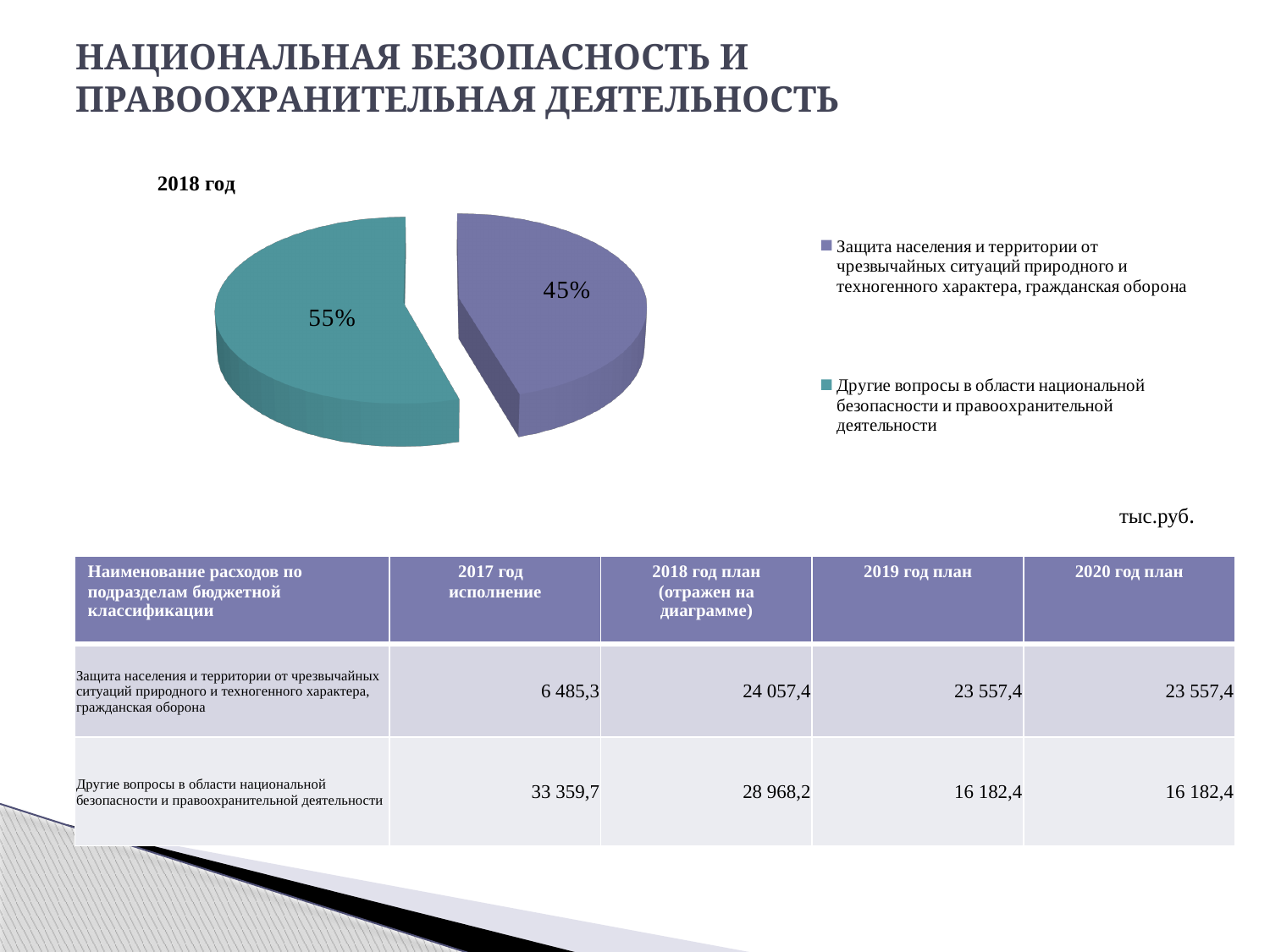
Which is larger in the pie chart: the share for "Защита населения и территории..." or the share for "Другие вопросы..."? Другие вопросы в области национальной безопасности и правоохранительной деятельности What share of the pie does "Защита населения и территории от чрезвычайных ситуаций природного и техногенного характера, гражданская оборона" take? 45% Which slice of the pie chart is the smallest? Защита населения и территории от чрезвычайных ситуаций природного и техногенного характера, гражданская оборона Which slice of the pie chart is the largest? Другие вопросы в области национальной безопасности и правоохранительной деятельности By how many percentage points does the 55% slice exceed the 45% slice? 10 Is the share for "Защита населения и территории от чрезвычайных ситуаций..." greater or less than 50%? less What kind of chart is shown on the slide? pie chart What is the title of the pie chart? 2018 год What share of the pie does "Другие вопросы в области национальной безопасности и правоохранительной деятельности" take? 55% How many entries does the legend of the pie chart list? 2 What colour is the slice representing "Другие вопросы в области национальной безопасности и правоохранительной деятельности"? teal How many slices does the pie chart have? 2